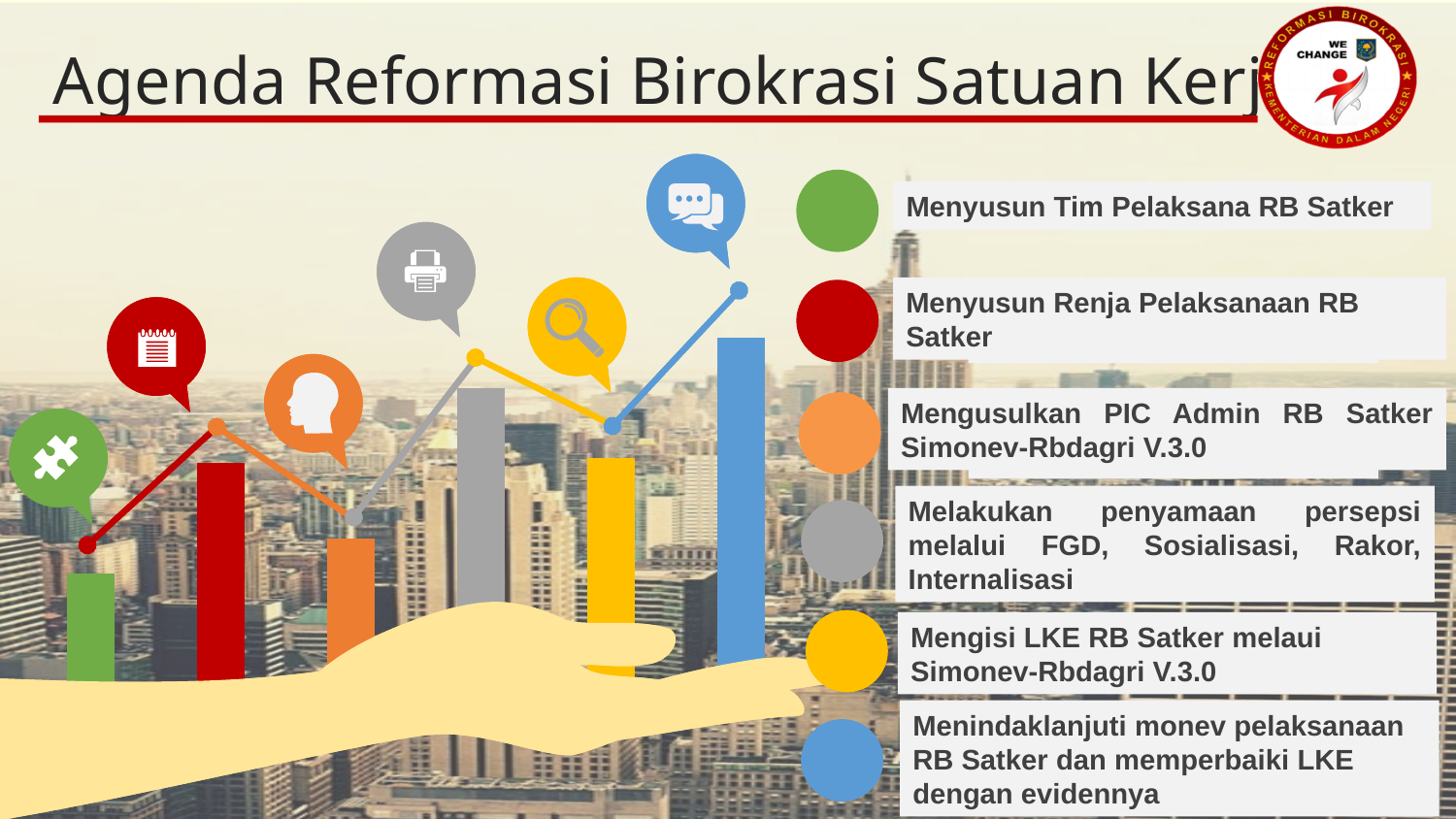
What kind of chart is shown on the slide? bar chart Which colour bar is the shortest in the chart? green Which is taller in the chart, the gray bar or the orange bar? the gray bar Which is taller in the chart, the red bar or the green bar? the red bar How many bars does the chart on the slide contain? 6 Which colour bar is the tallest in the chart? blue What colour is the leftmost bar in the chart? green What colour is the rightmost bar in the chart? blue Do the bars in the chart rise or fall overall from left to right? rise Which is taller in the chart, the blue bar or the yellow bar? the blue bar